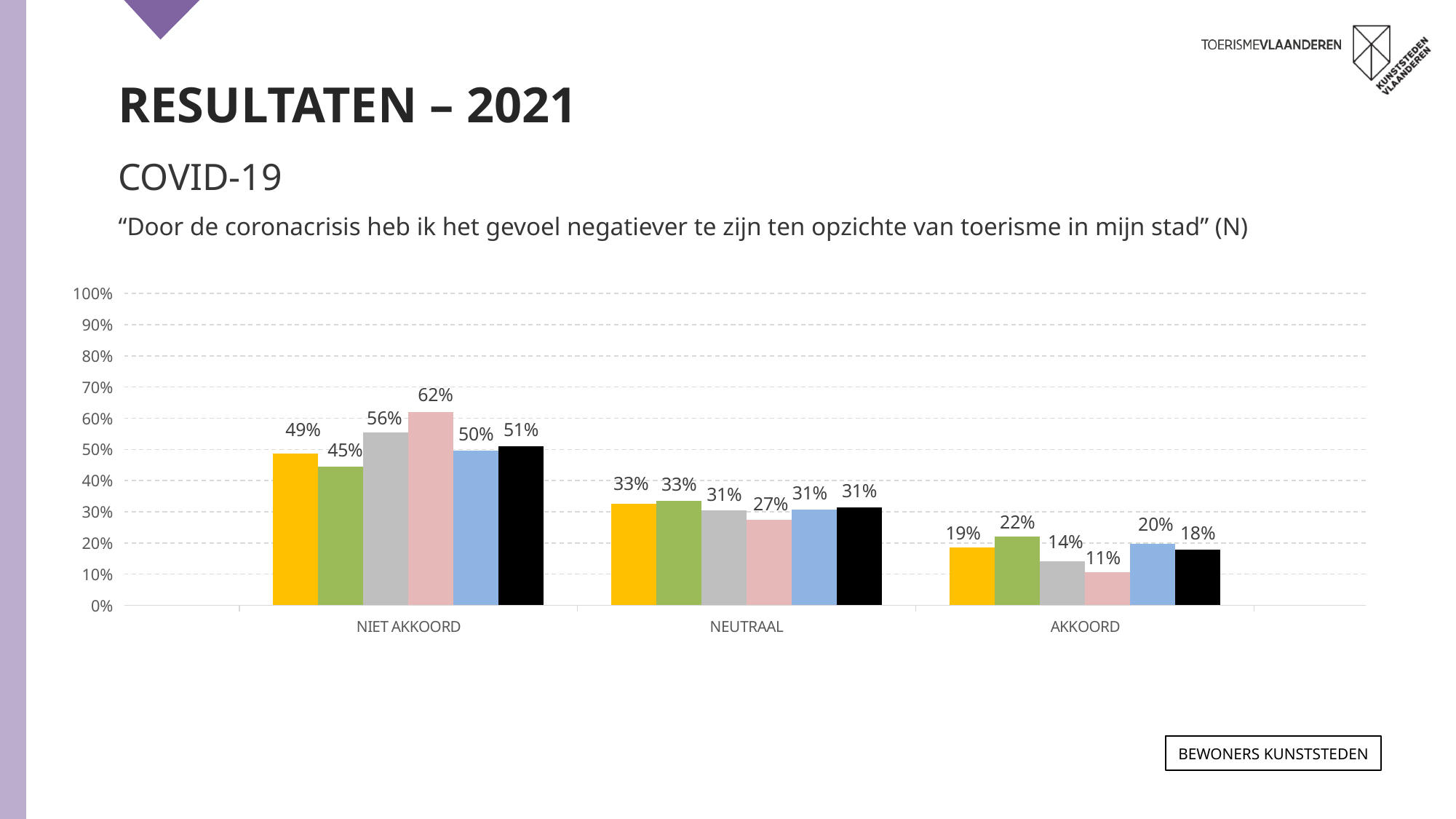
What type of chart is shown on the slide? bar chart How many bars are plotted for the NEUTRAAL category? 6 Which bar in the AKKOORD group has the lowest value? the pink bar (11%) Which is larger: the green bar for AKKOORD or the grey bar for AKKOORD? the green bar (22%) What is the value of the pink bar for NIET AKKOORD? 62% What is the difference between the pink bar for NIET AKKOORD (62%) and the pink bar for AKKOORD (11%)? 51% What is the highest value shown on the y axis of the chart? 100% Is the value of the grey bar for NIET AKKOORD greater or less than 50%? greater What is the value of the yellow bar for AKKOORD? 19% Which bar in the NIET AKKOORD group has the highest value? the pink bar (62%) What is the value of the black bar for NEUTRAAL? 31% How many categories are shown on the x axis of the chart? 3